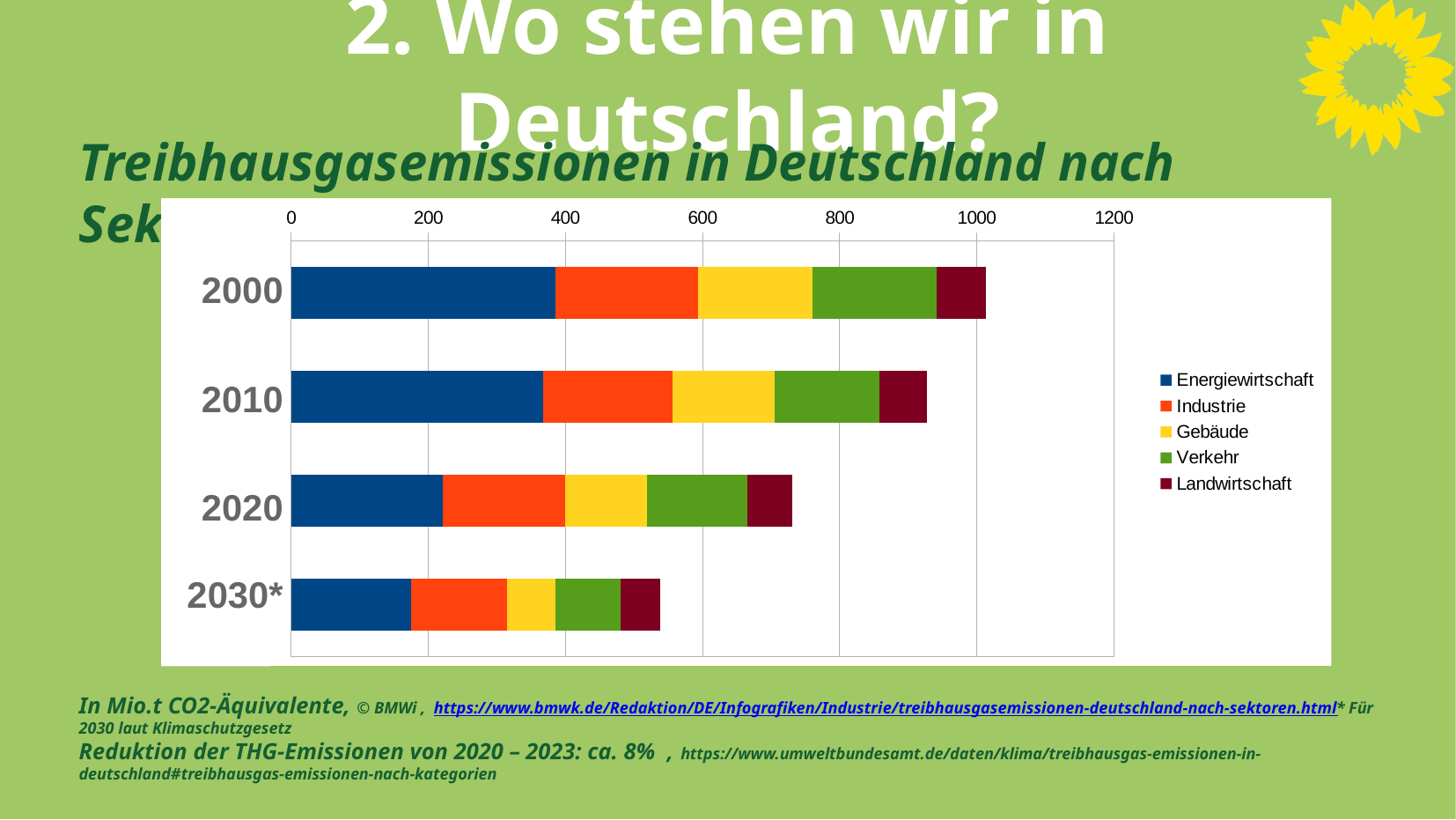
How many series does the legend list? 5 Which series is shown in dark blue in the legend? Energiewirtschaft Is the total bar for 2010 greater or less than 1000? less Do the total emissions rise or fall from 2000 to 2030*? fall Which year has the longest total bar? 2000 Which is larger, the Energiewirtschaft segment for 2010 or for 2020? 2010 Is the total bar for 2020 greater or less than 800? less Is the total bar for 2030* greater or less than 600? less Which year has the shortest total bar? 2030* How many years (categories) are plotted on the chart? 4 What kind of chart is shown on the slide? stacked bar chart